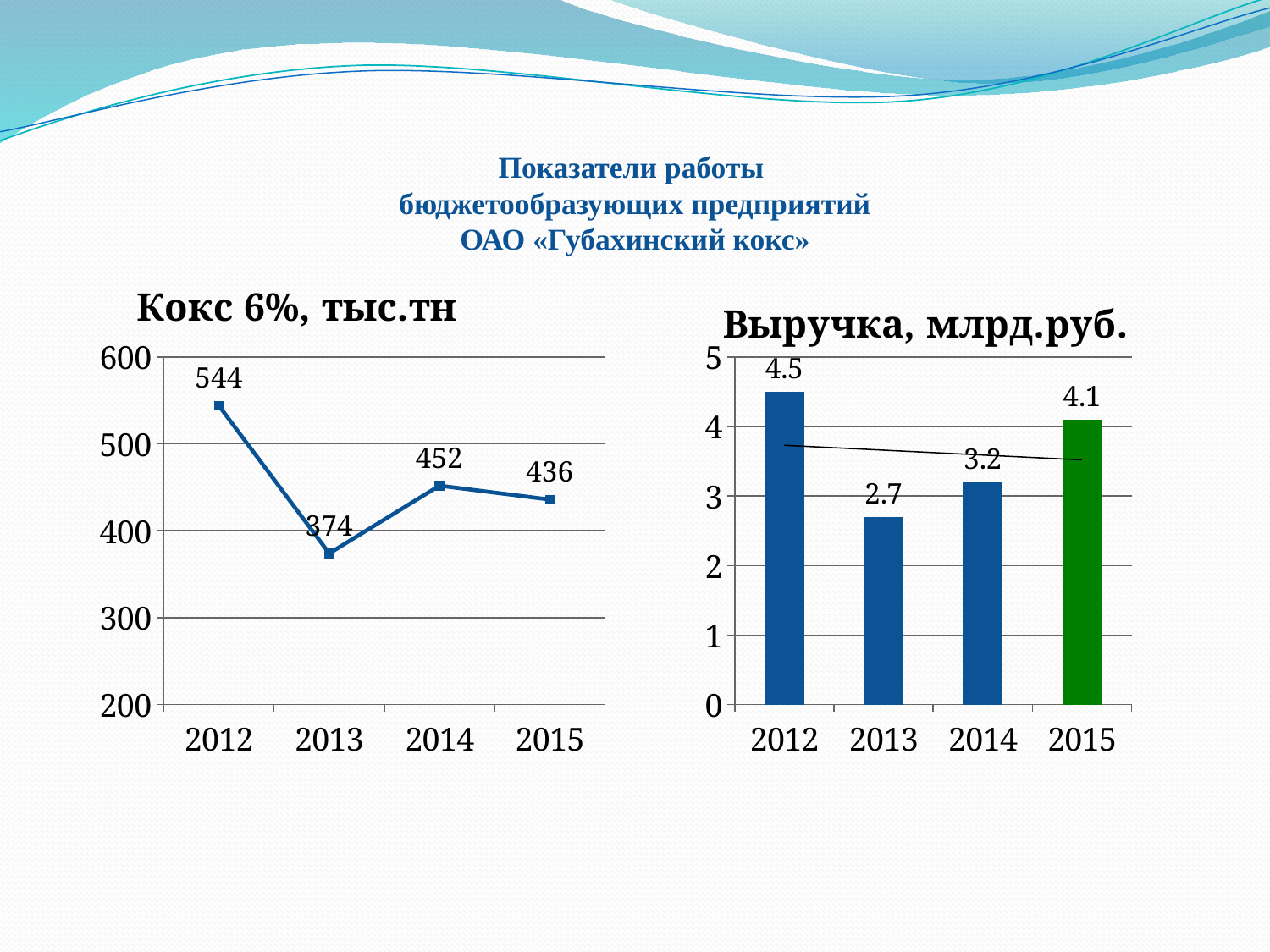
In the chart titled "Кокс 6%, тыс.тн", what is the value for 2012? 544 In the chart titled "Выручка, млрд.руб.", what kind of chart is shown? bar chart In the chart titled "Выручка, млрд.руб.", what is the value for 2013? 2.7 In the chart titled "Выручка, млрд.руб.", which year has the highest value? 2012 In the chart titled "Выручка, млрд.руб.", what is the difference between the 2015 and 2014 values? 0.9 In the chart titled "Кокс 6%, тыс.тн", what kind of chart is shown? line chart In the chart titled "Кокс 6%, тыс.тн", what is the difference between the 2012 and 2013 values? 170 In the chart titled "Выручка, млрд.руб.", which bar is coloured green? 2015 In the chart titled "Кокс 6%, тыс.тн", is the value for 2014 larger or smaller than the value for 2015? larger In the chart titled "Кокс 6%, тыс.тн", how many data points are plotted? 4 In the chart titled "Выручка, млрд.руб.", do the values rise or fall from 2013 to 2015? rise In the chart titled "Кокс 6%, тыс.тн", which year has the lowest value? 2013